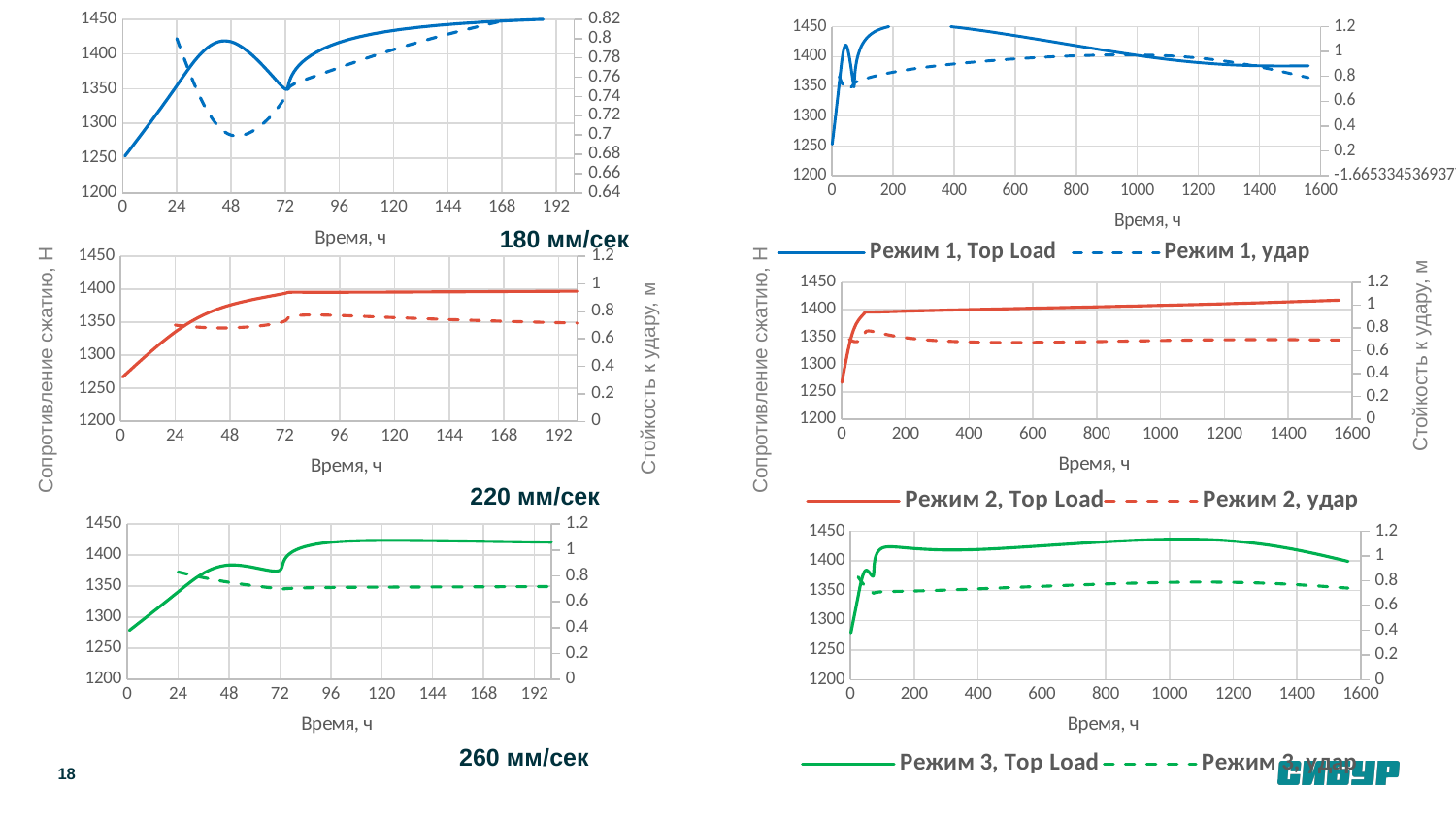
What are the two legend entries of the middle-right chart? Режим 2, Top Load; Режим 2, удар In the bottom-right chart (Режим 3), is the solid line value at 1000 h greater or less than 1400? greater In the 220 мм/сек chart (middle left), is the dashed line value at 96 h greater or less than 0.6 on the right axis? greater How many charts are shown on the slide? 6 In the middle-right chart (Режим 2), is the solid line value at 0 h greater or less than 1300? less How many series does the legend list for the top-right chart (Режим 1)? 2 In the top-right chart (Режим 1), does the solid Top Load line rise or fall between 400 h and 1600 h? fall What kind of chart is the top-left chart labelled 180 мм/сек? line chart What colour are the lines for Режим 3 in the bottom-right chart? green In the 220 мм/сек chart (middle left), does the solid line rise or fall between 0 h and 72 h? rise